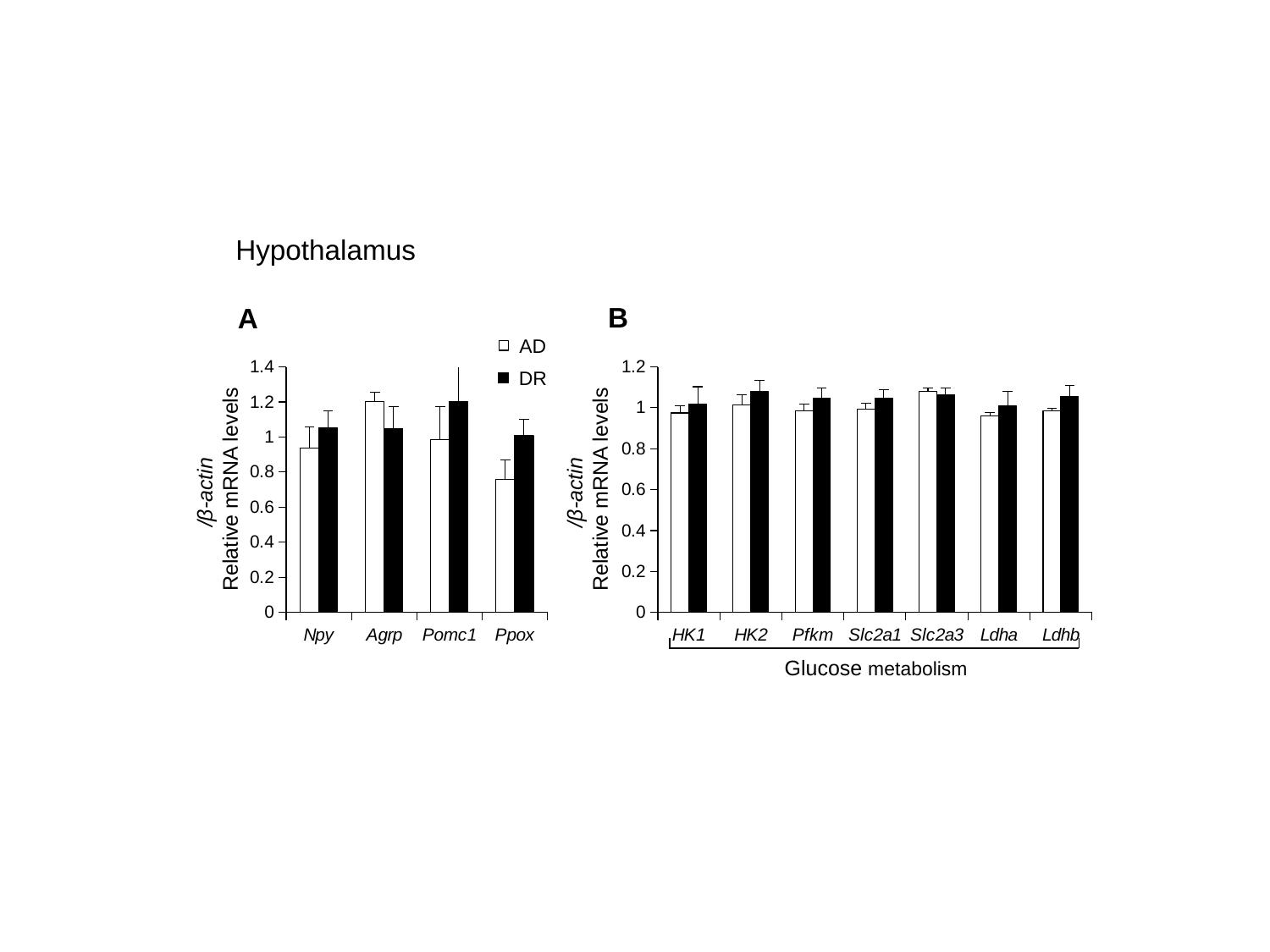
In chart A, is the DR value for Pomc1 greater or less than 1? greater How many categories are shown on the x axis of chart A on the left? 4 In chart B, is the DR value for HK1 greater or less than 0.8? greater What kind of chart is chart A on the left? bar chart What group label is written under the x axis of chart B? Glucose metabolism In chart A, is the AD value for Agrp greater or less than 1? greater How many gene categories are shown on the x axis of chart B on the right? 7 In chart A, which is larger, the AD value for Agrp or the AD value for Ppox? Agrp How many series does the legend on chart A list? 2 In chart A, which category has the highest AD bar? Agrp In chart A, which category has the lowest AD bar? Ppox